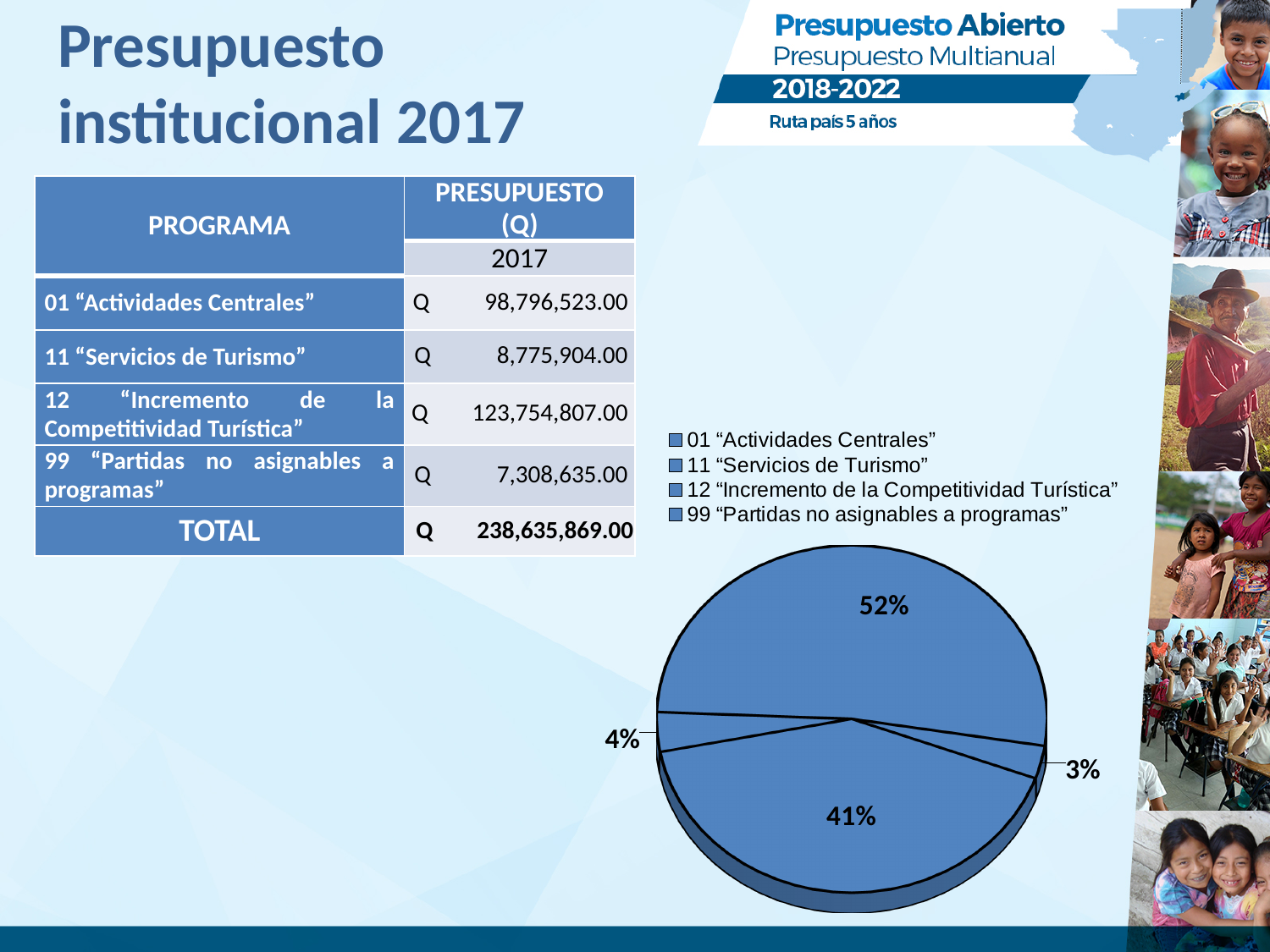
How many entries does the pie chart's legend list? 4 What kind of chart is shown on the slide? pie chart What is the first entry listed in the pie chart's legend? 01 "Actividades Centrales" How many slices does the pie chart have? 4 What is the last entry listed in the pie chart's legend? 99 "Partidas no asignables a programas" Which is larger on the pie chart, the slice labelled 41% or the slice labelled 52%? 52% What is the difference between the slices labelled 52% and 41% on the pie chart? 11% What is the smallest percentage labelled on the pie chart? 3% What is the largest percentage labelled on the pie chart? 52% Is the largest slice of the pie chart greater or less than 50%? greater What is the difference between the largest and smallest slice percentages on the pie chart? 49% What is the difference between the slices labelled 4% and 3% on the pie chart? 1%